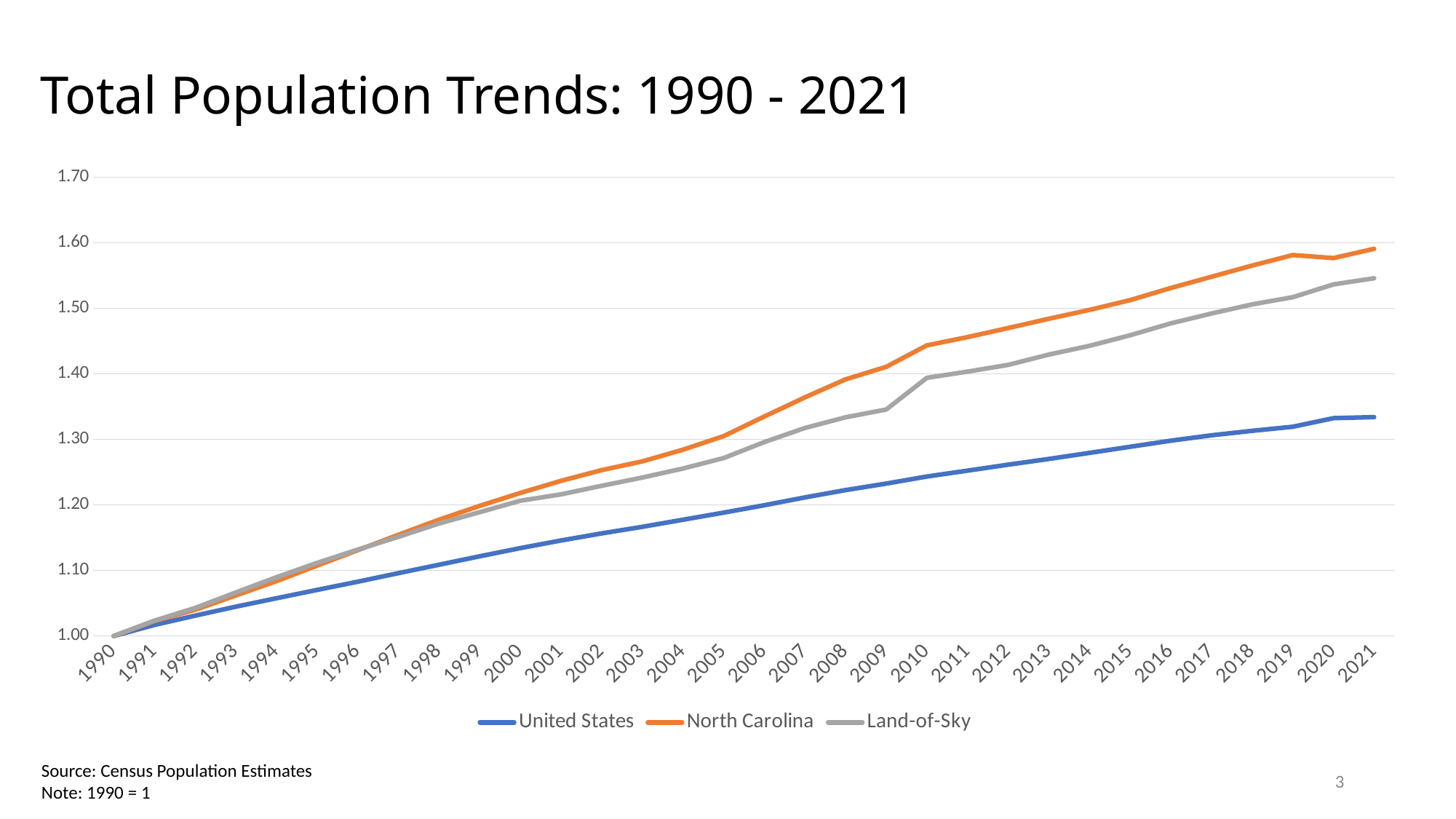
What is the title of the chart? Total Population Trends: 1990 - 2021 What is the value for North Carolina in 1990? 1.00 Which is larger in 2010, the value for Land-of-Sky or the value for United States? Land-of-Sky What kind of chart is shown on the slide? line chart Is the value for United States in 2021 greater or less than 1.30? greater How many years are plotted along the x axis? 32 How many series does the legend list? 3 Is the value for Land-of-Sky in 2009 greater or less than 1.40? less Do the values for United States rise or fall from 1990 to 2021? rise Which series has the lowest value in 2021? United States Which series has the highest value in 2021? North Carolina